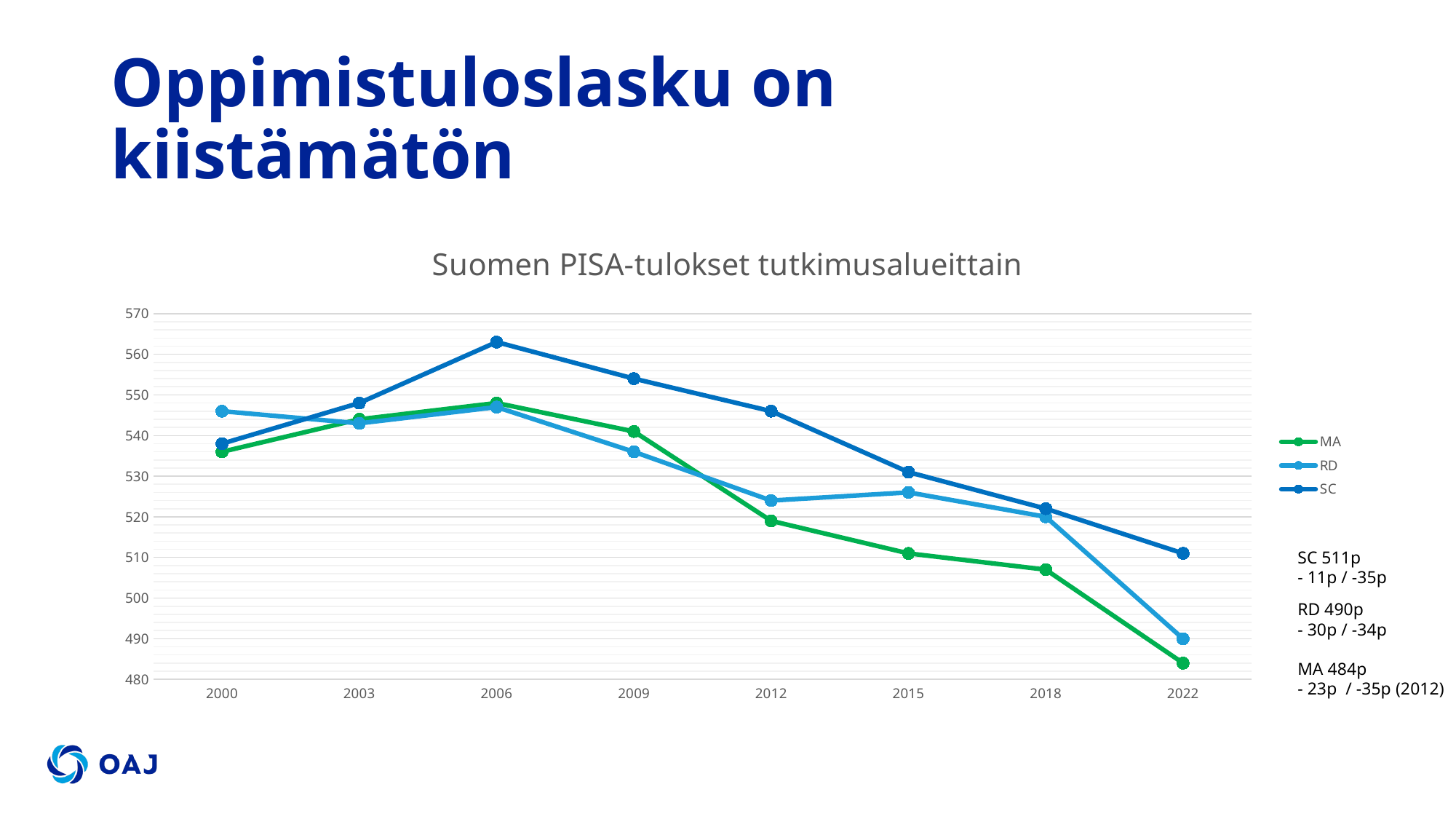
Is the SC value for 2006 greater or less than 560? greater What is the RD score for 2022? 490p What is the MA score for 2022? 484p What is the SC score for 2022? 511p Do the MA values rise or fall from 2006 to 2022? fall Which series has the highest value in 2022? SC What kind of chart is shown on the slide? line chart Is the MA value for 2018 greater or less than 510? less What is the difference between the SC and MA scores in 2022? 27p How many years are shown on the x axis? 8 How many series does the legend list? 3 Which series has the lowest value in 2022? MA